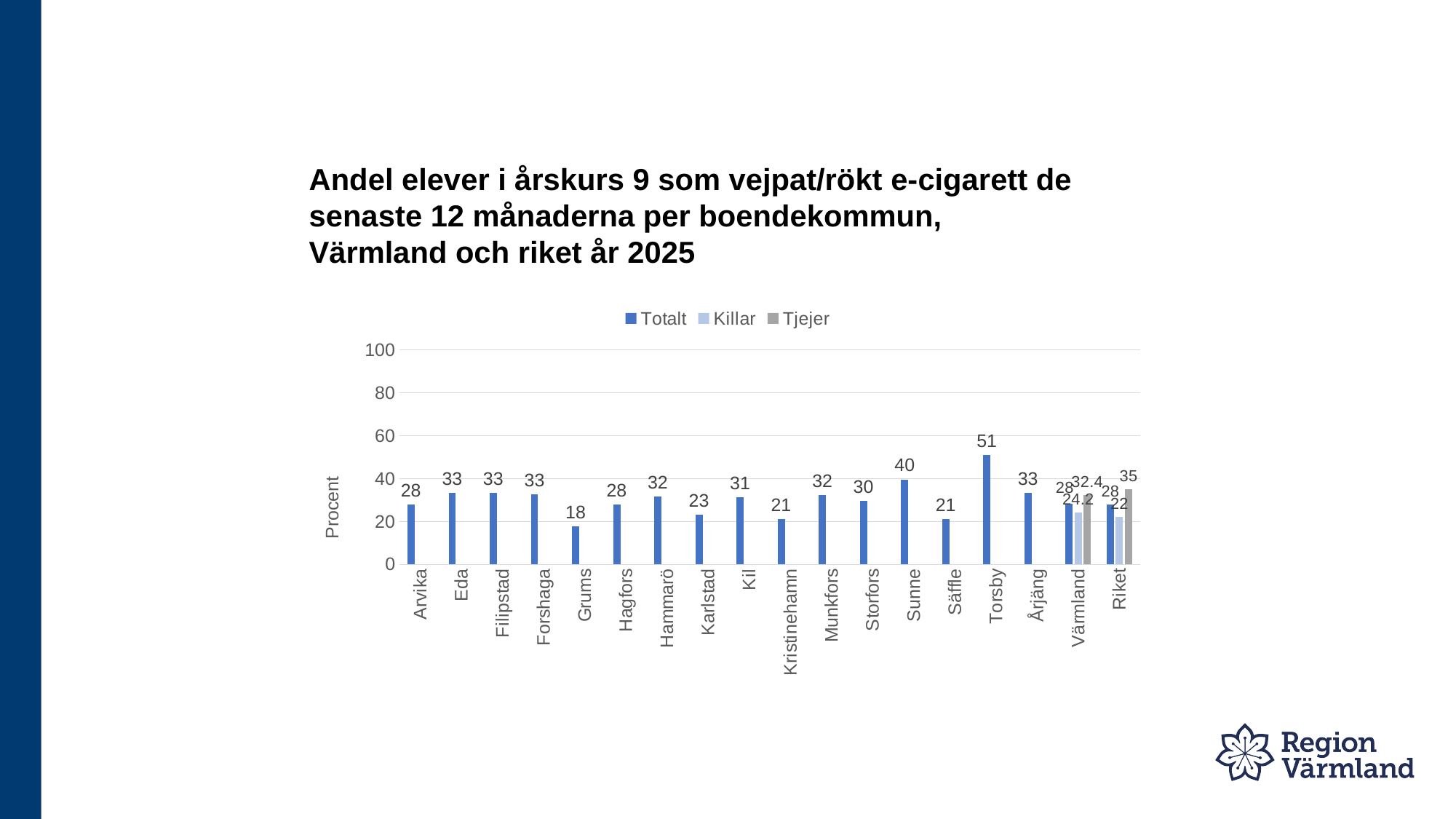
How many categories are shown on the x axis? 18 Which municipality has the highest Totalt value? Torsby Which has a larger Totalt value, Sunne or Storfors? Sunne How many series does the legend list? 3 What is the Killar value for Värmland? 24.2 What is the Totalt value for Torsby? 51 Which category has the lowest Totalt value? Grums What is the difference between the Tjejer and Killar values for Riket? 13 What kind of chart is shown on the slide? bar chart What is the difference between the Totalt values for Torsby and Grums? 33 What is the label on the y axis? Procent What is the Tjejer value for Riket? 35